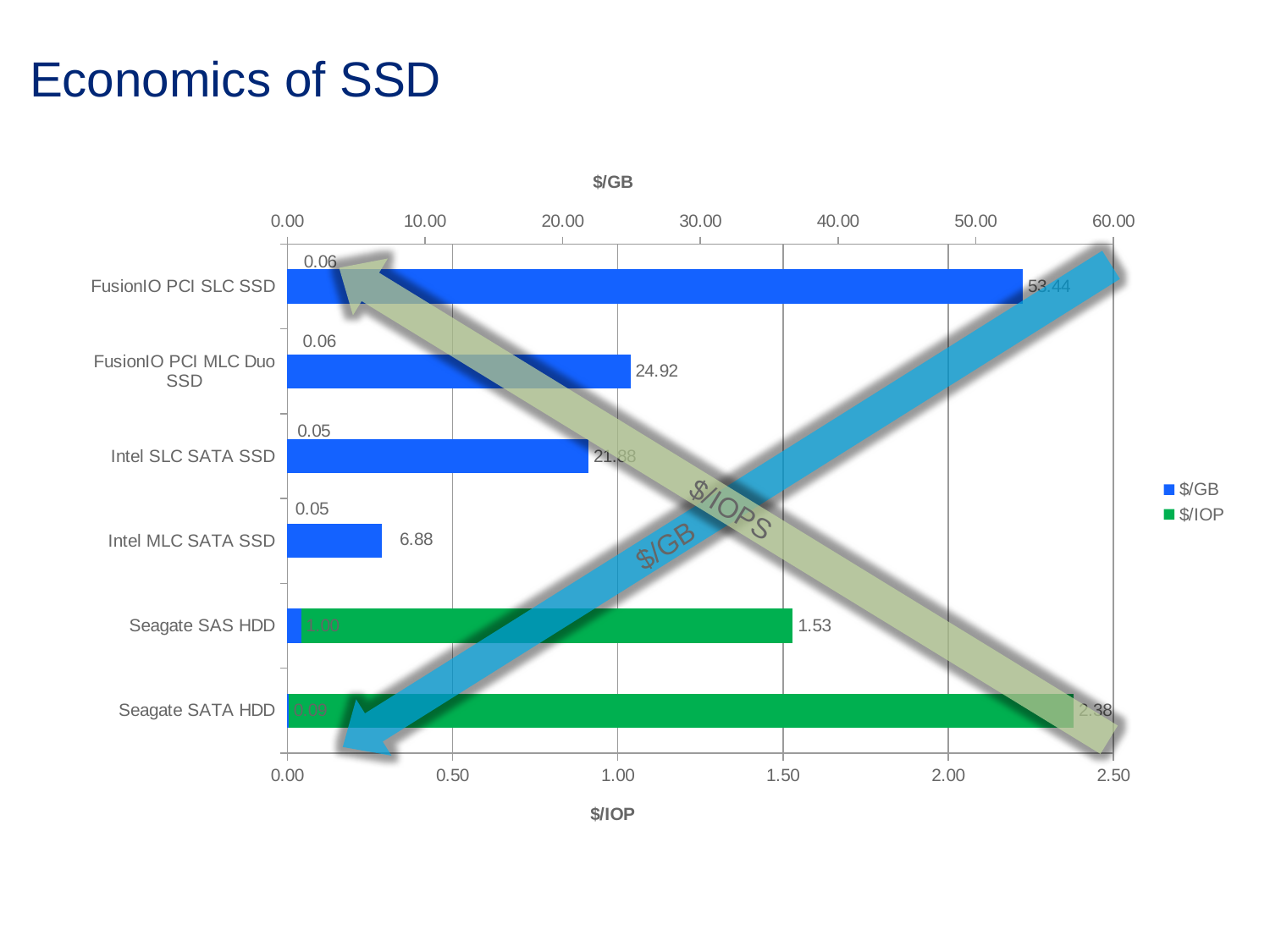
What is the $/IOP value for Seagate SAS HDD? 1.53 Which device has the highest $/IOP value? Seagate SATA HDD What is the $/GB value for FusionIO PCI MLC Duo SSD? 24.92 How many storage devices (categories) are plotted on the chart? 6 Which device has the highest $/GB value? FusionIO PCI SLC SSD What is the $/IOP value for FusionIO PCI MLC Duo SSD? 0.06 What is the $/GB value for Intel MLC SATA SSD? 6.88 What is the difference in $/GB between FusionIO PCI MLC Duo SSD and Intel MLC SATA SSD? 18.04 Which has the larger $/GB value, Intel SLC SATA SSD or Intel MLC SATA SSD? Intel SLC SATA SSD What kind of chart is shown on the slide? bar chart How many series does the legend list? 2 Is the $/GB value for FusionIO PCI SLC SSD greater or less than 50.00? greater